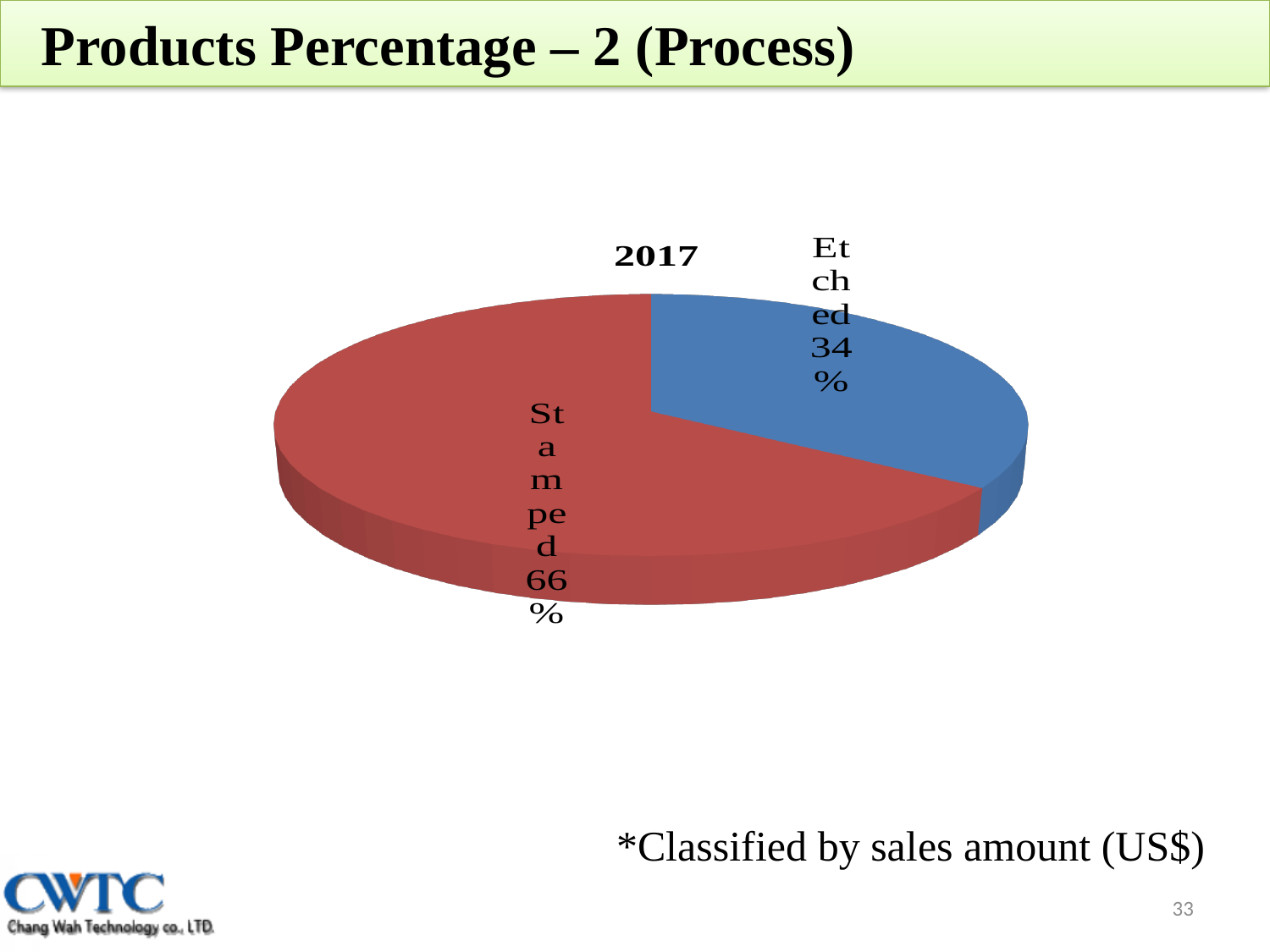
What colour is the Etched slice of the pie chart? Blue What is the difference in percentage points between the Stamped and Etched slices? 32 Which slice of the pie chart is the largest? Stamped Which slice of the pie chart is the smallest? Etched How many slices does the pie chart have? 2 What percentage of the pie chart is Stamped? 66% What is the title of the pie chart? 2017 What share of the pie does the Stamped slice represent? 66% What kind of chart is shown on the slide? Pie chart Which is larger, the Stamped slice or the Etched slice? Stamped What percentage of the pie chart is Etched? 34%